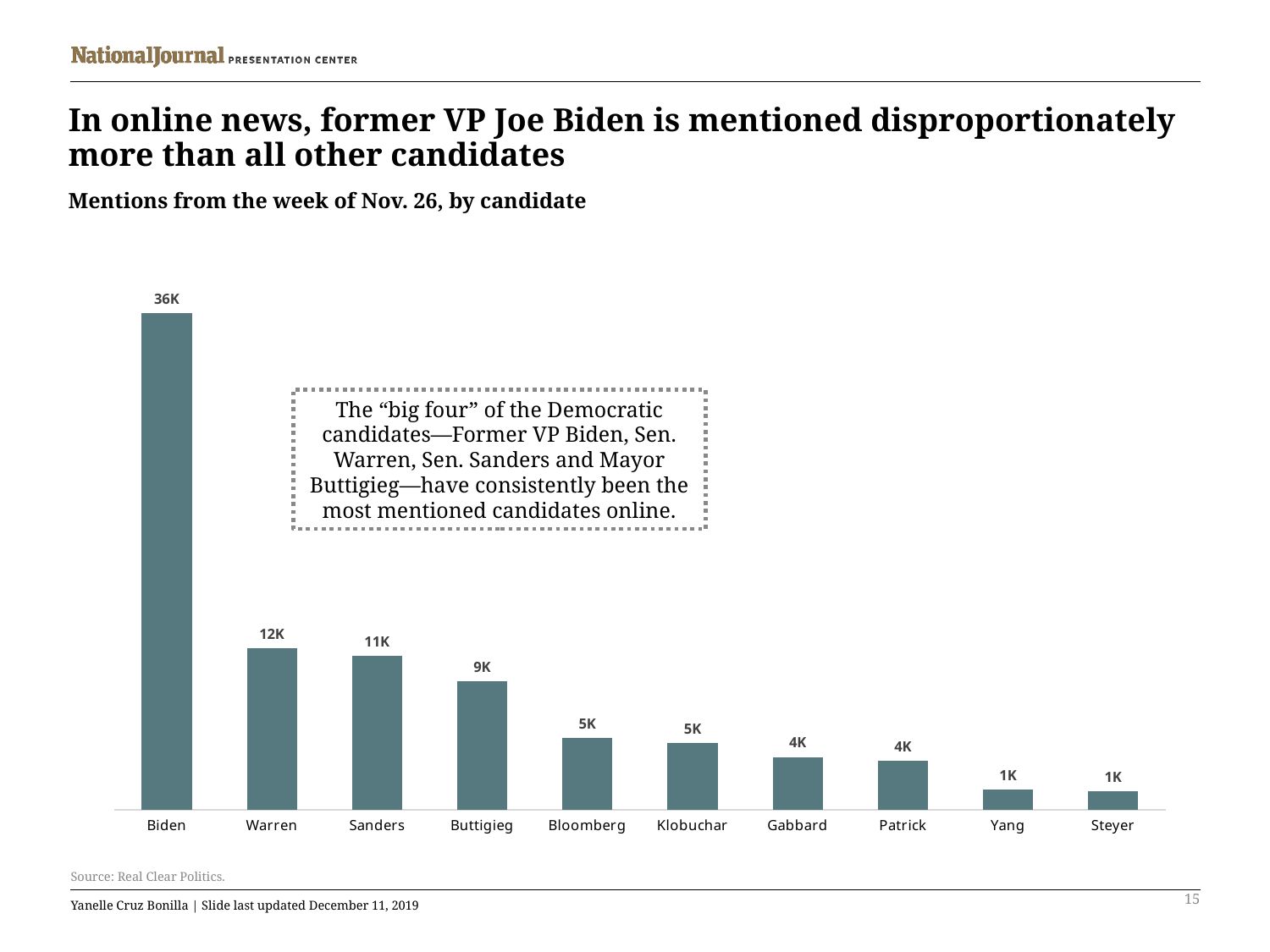
What is the subtitle of the chart? Mentions from the week of Nov. 26, by candidate How many mentions did Gabbard receive? 4K Who has more mentions, Buttigieg or Klobuchar? Buttigieg What kind of chart is shown on the slide? Bar chart Which candidate has the most mentions? Biden How many mentions did Biden receive? 36K Who has more mentions, Warren or Sanders? Warren How many mentions did Buttigieg receive? 9K How many candidates are shown in the chart? 10 Do the values rise or fall moving from left to right across the candidates? Fall What is the difference in mentions between Biden and Warren? 24K What is the difference in mentions between Sanders and Bloomberg? 6K